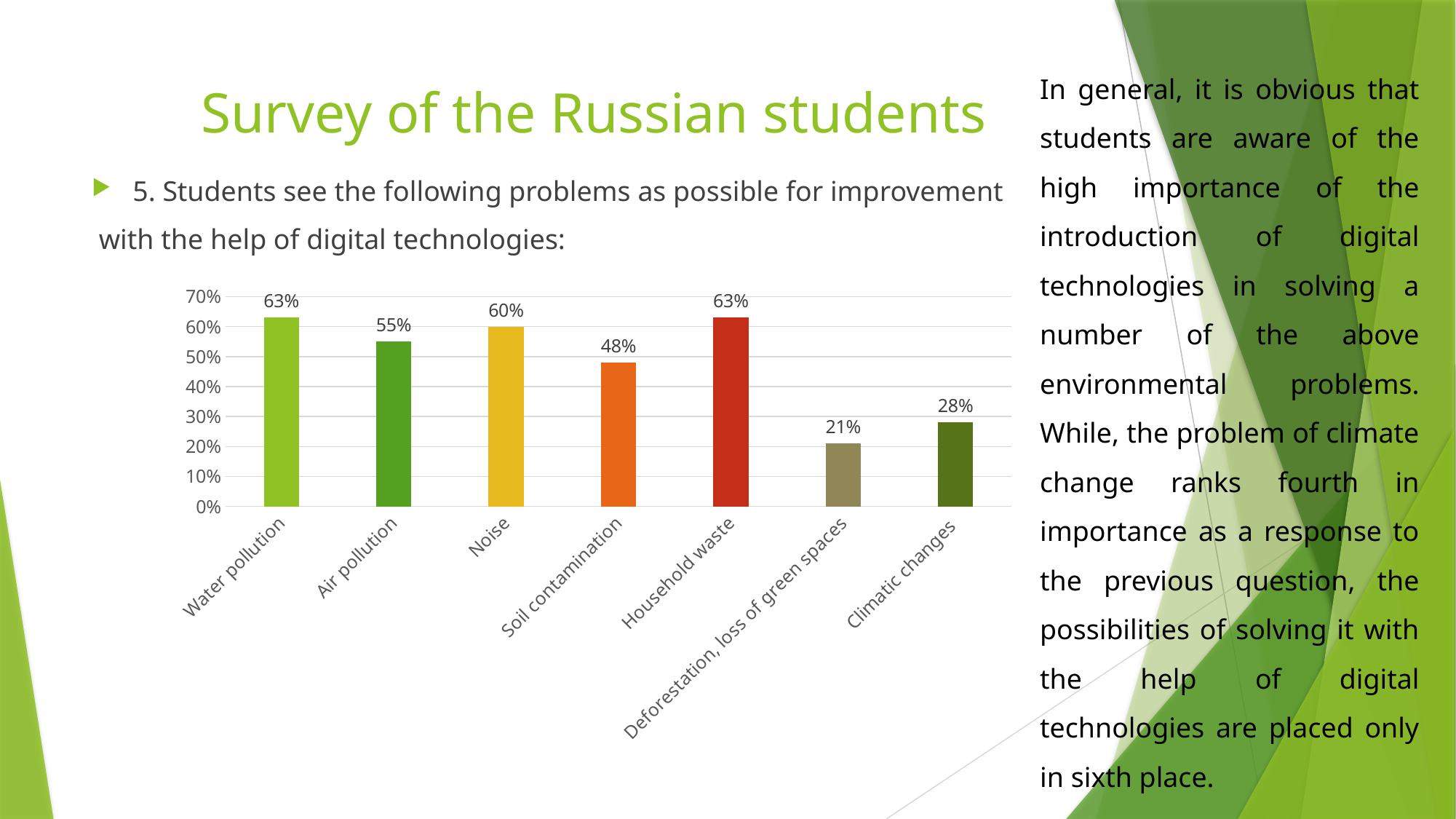
How many categories are shown in the chart? 7 What is the value shown for Noise? 60% What is the difference between the values for Noise and Soil contamination? 12% What is the value shown for Soil contamination? 48% Is the value for Household waste greater or less than 50%? greater What is the difference between the values for Air pollution and Climatic changes? 27% What percentage of students chose Water pollution as a problem that could be improved with digital technologies? 63% What is the title of the slide containing the chart? Survey of the Russian students Which category has the lowest value in the chart? Deforestation, loss of green spaces Which is larger, the value for Air pollution or the value for Soil contamination? Air pollution What kind of chart is shown on the slide? Bar chart What is the value shown for Climatic changes? 28%